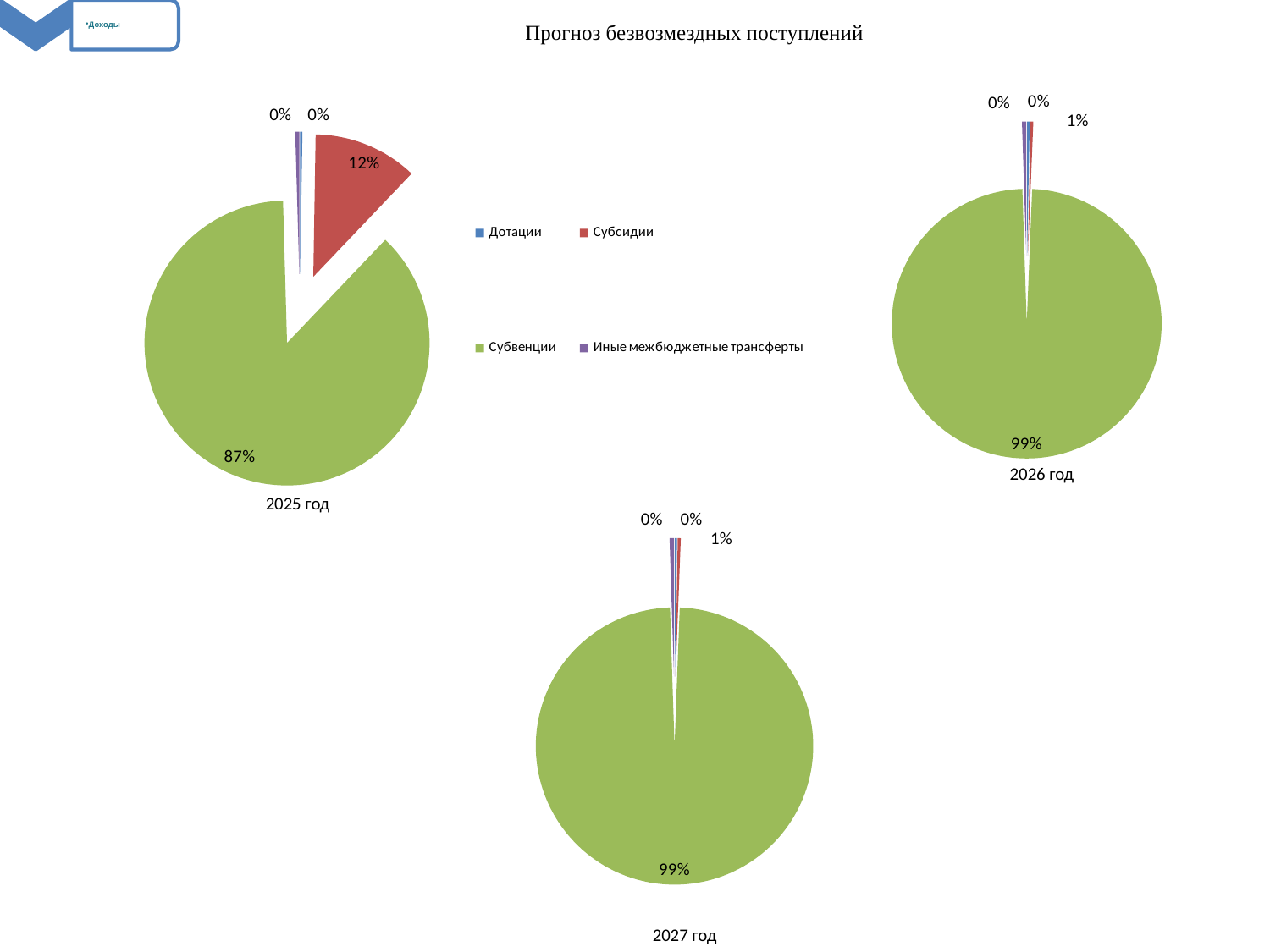
In the 2025 год pie chart, which category has the largest share? Субвенции How many pie charts are on the slide? 3 In the 2026 год pie chart, what share is shown for Субвенции? 99% In the 2027 год pie chart, what share is shown for Субсидии? 0% In the 2025 год pie chart, what share is shown for Субсидии? 12% In the 2025 год pie chart, what is the difference between the shares of Субвенции and Субсидии? 75% In the 2026 год pie chart, which is larger: the share of Субвенции or the share of Субсидии? Субвенции What kind of chart is used for 2025 год? Pie chart In the 2025 год pie chart, what share is shown for Субвенции? 87% In the 2027 год pie chart, which category has the largest share? Субвенции What is the title of the slide's charts? Прогноз безвозмездных поступлений How many series does the legend list? 4